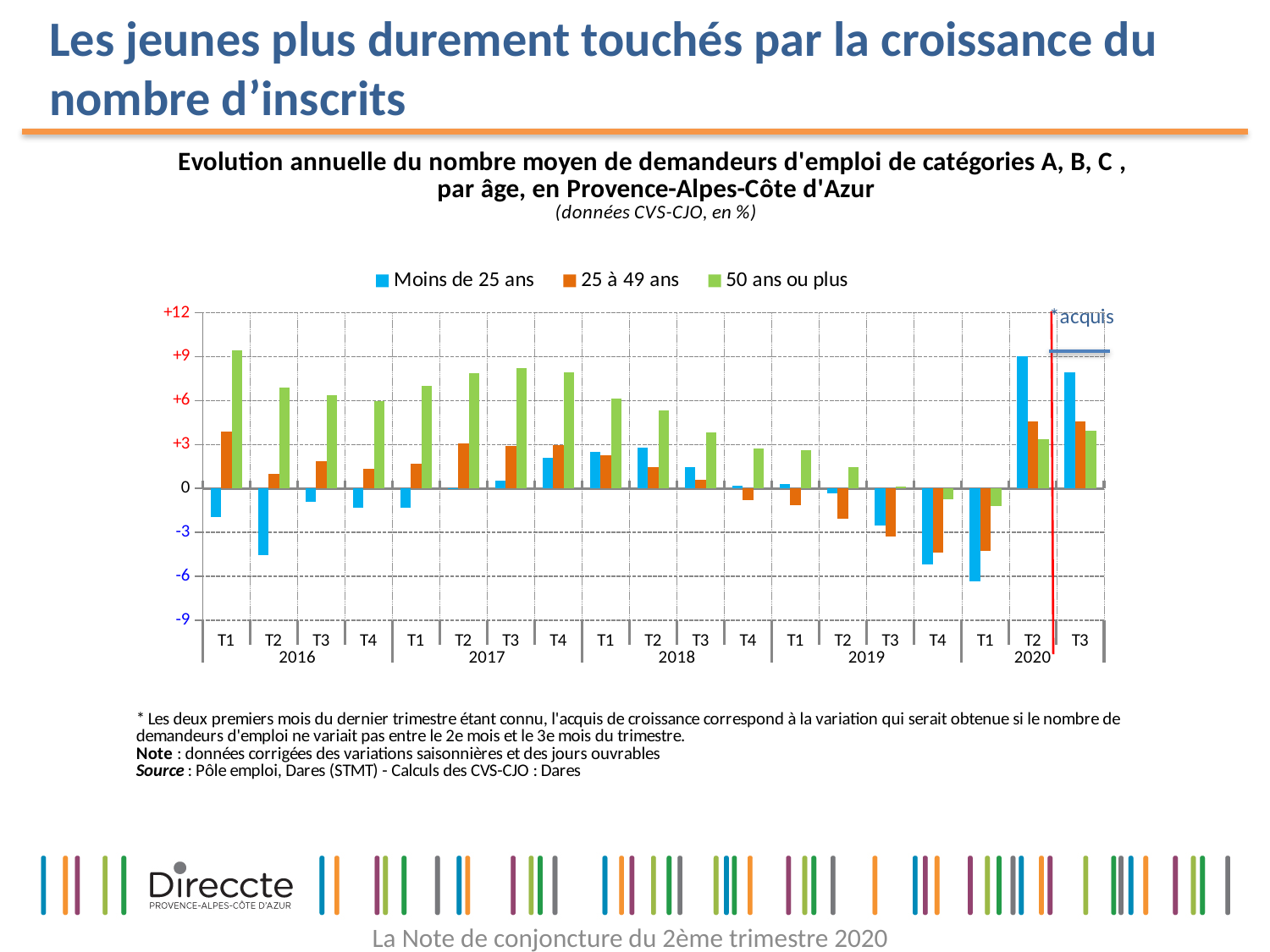
Is the value for '50 ans ou plus' in T1 2016 greater or less than +6? greater Is the value for 'Moins de 25 ans' in T2 2020 greater or less than +6? greater How many quarters (T1–T4 periods) are plotted along the x axis? 19 In which quarter does the '50 ans ou plus' series reach its highest value? T1 2016 Is the value for 'Moins de 25 ans' in T2 2016 greater or less than -3? less Does the '50 ans ou plus' series generally rise or fall from T1 2016 to T1 2020? fall Which colour represents the 'Moins de 25 ans' series? blue In which quarter does the 'Moins de 25 ans' series reach its lowest value? T1 2020 What kind of chart is shown on the slide? bar chart How many series does the legend list? 3 In T2 2020, which is larger: the value for 'Moins de 25 ans' or for '25 à 49 ans'? Moins de 25 ans